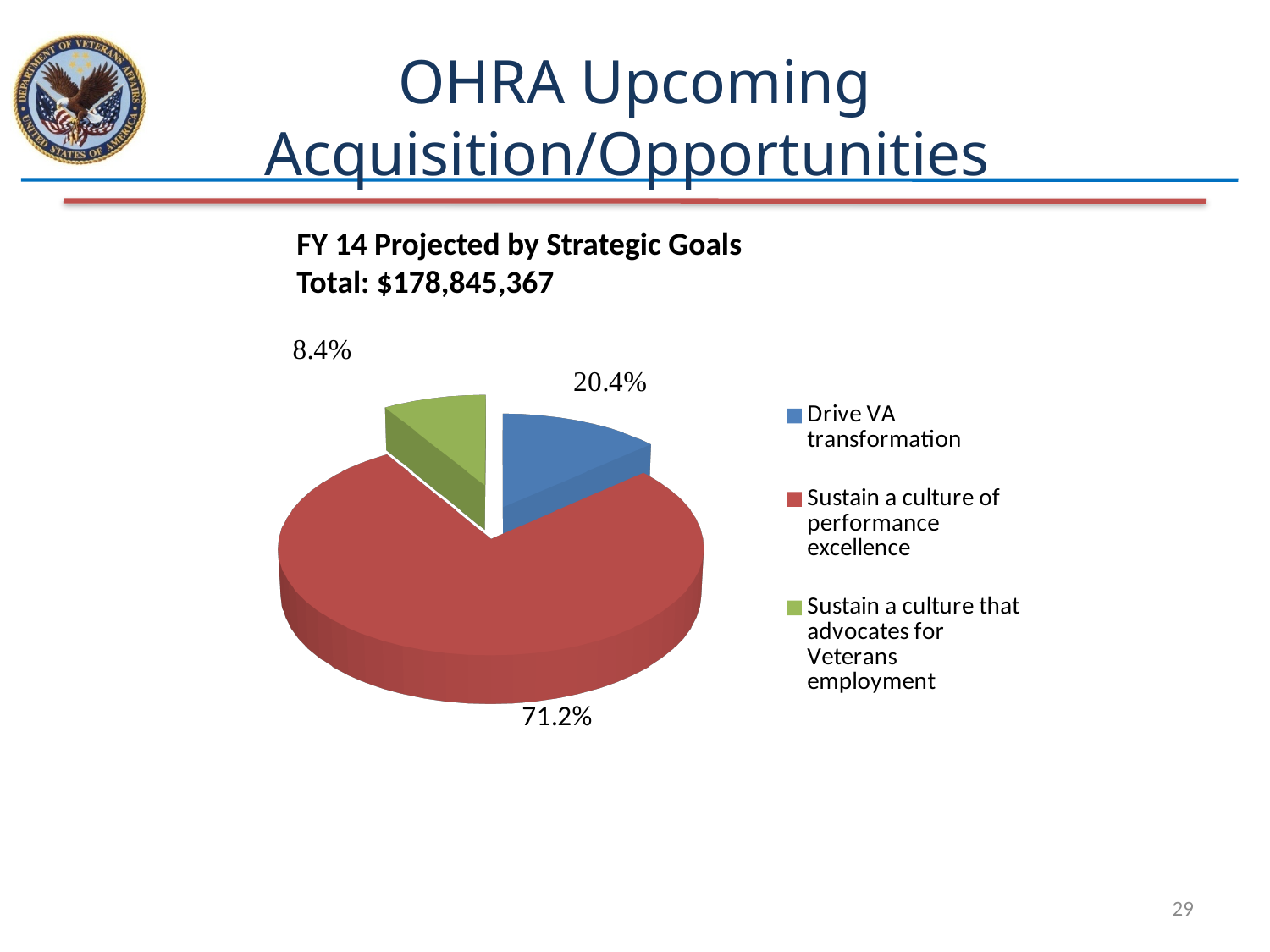
Which strategic goal has the largest share of the pie? Sustain a culture of performance excellence What kind of chart is shown on the slide? Pie chart Which strategic goal has the smallest share of the pie? Sustain a culture that advocates for Veterans employment What share of the pie does "Drive VA transformation" represent? 20.4% Which is larger: the share for "Drive VA transformation" or the share for "Sustain a culture that advocates for Veterans employment"? Drive VA transformation How many entries does the legend list? 3 What share of the pie does "Sustain a culture of performance excellence" represent? 71.2% What share of the pie does "Sustain a culture that advocates for Veterans employment" represent? 8.4% What colour is the slice for "Sustain a culture of performance excellence"? Red What is the difference in percentage points between the "Sustain a culture of performance excellence" slice and the "Drive VA transformation" slice? 50.8 percentage points What total amount is stated in the chart title? $178,845,367 How many slices does the pie chart have? 3